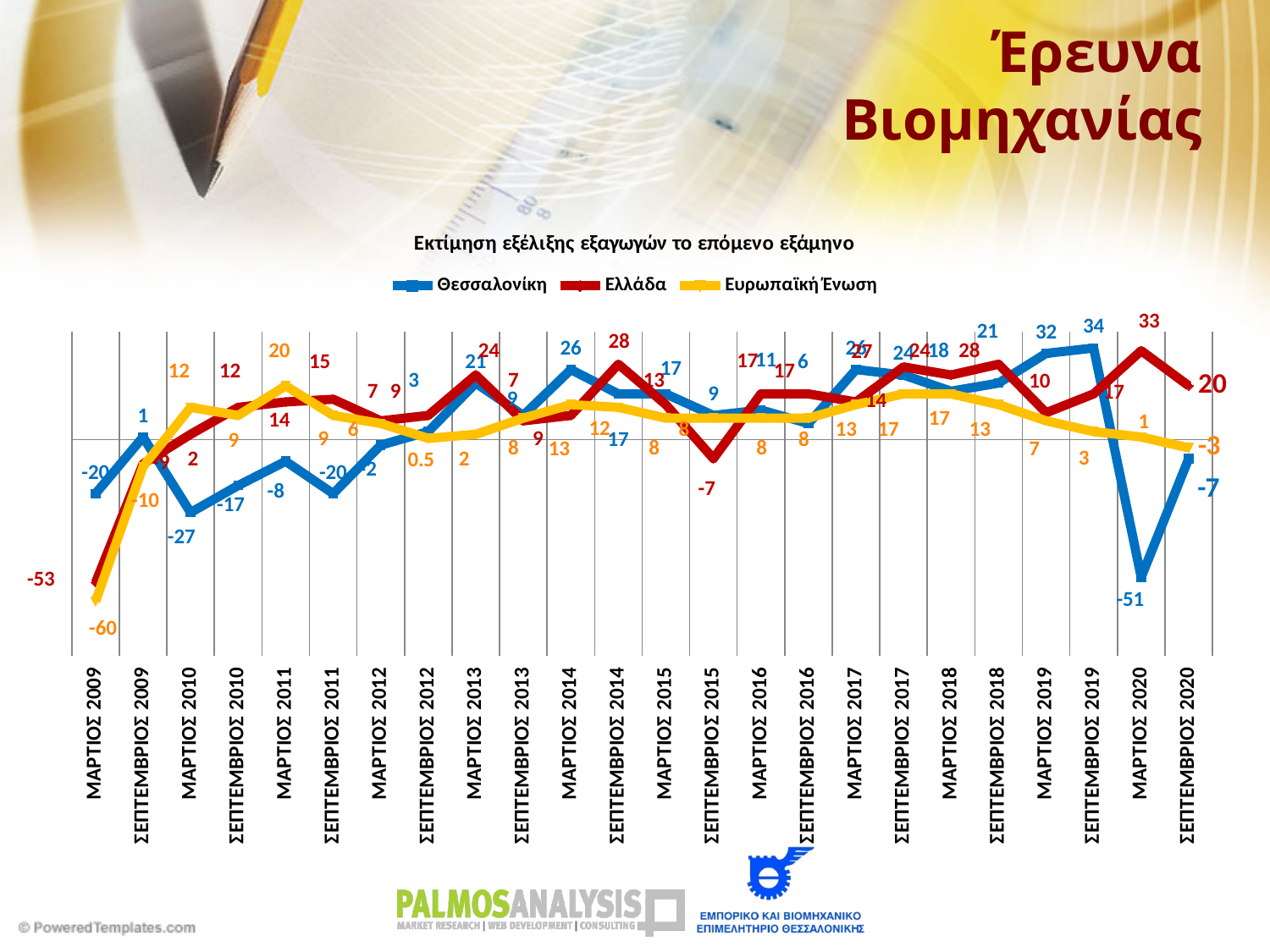
What is the difference between the Θεσσαλονίκη values in ΣΕΠΤΕΜΒΡΙΟΣ 2019 and ΜΑΡΤΙΟΣ 2020? 85 In which period does Ευρωπαϊκή Ένωση have its lowest value? ΜΑΡΤΙΟΣ 2009 In which period does Θεσσαλονίκη reach its highest value? ΣΕΠΤΕΜΒΡΙΟΣ 2019 What kind of chart is shown on the slide? Line chart What is the value for Ελλάδα in ΜΑΡΤΙΟΣ 2009? -53 Which is larger in ΜΑΡΤΙΟΣ 2020: the value for Ελλάδα or the value for Θεσσαλονίκη? Ελλάδα How many time points are plotted along the x axis? 24 Does the Θεσσαλονίκη value rise or fall from ΣΕΠΤΕΜΒΡΙΟΣ 2019 to ΜΑΡΤΙΟΣ 2020? Fall What is the value for Θεσσαλονίκη in ΜΑΡΤΙΟΣ 2020? -51 How many series does the legend list? 3 What is the value for Ευρωπαϊκή Ένωση in ΣΕΠΤΕΜΒΡΙΟΣ 2020? -3 What is the title of the chart? Εκτίμηση εξέλιξης εξαγωγών το επόμενο εξάμηνο